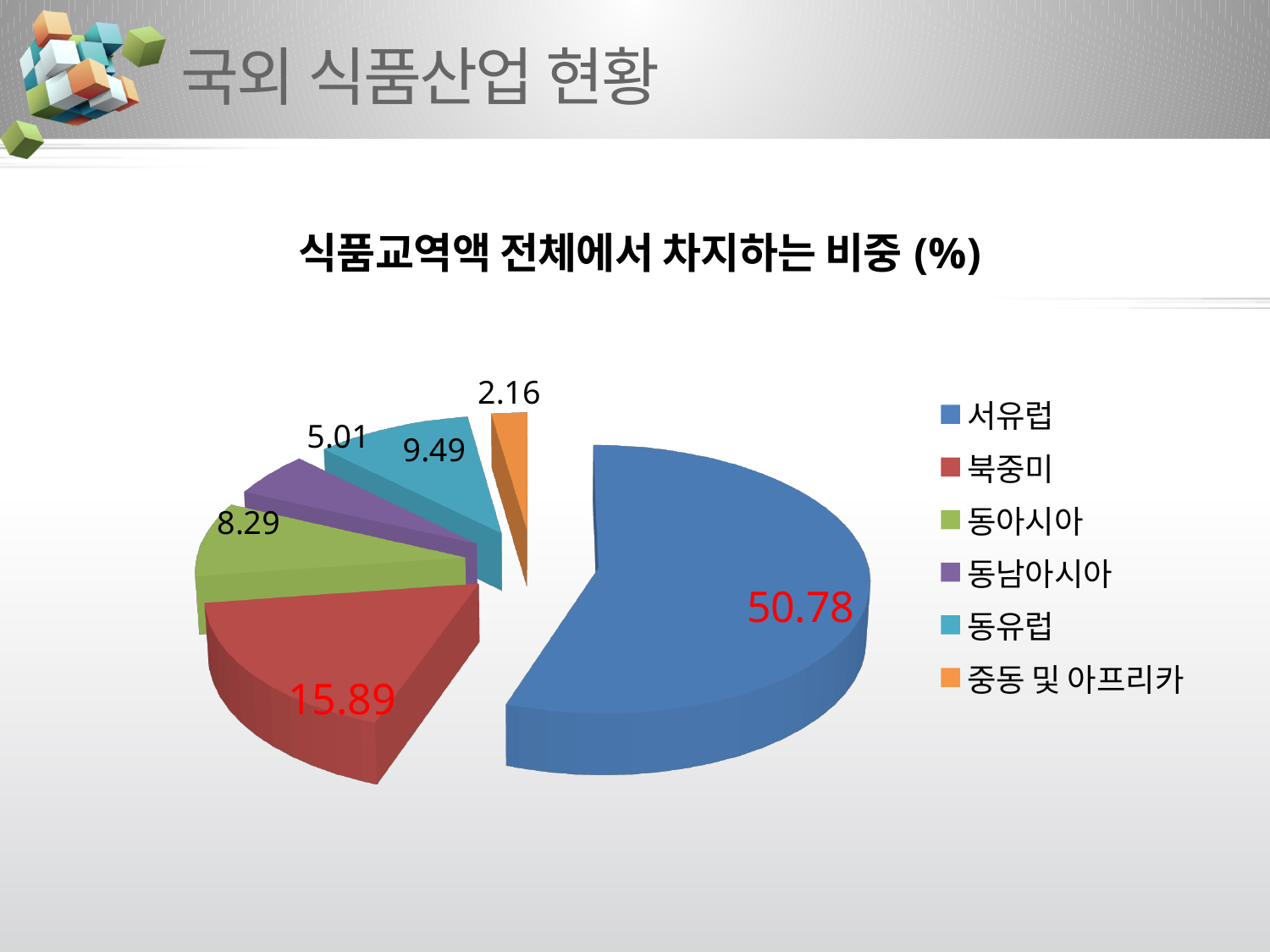
What type of chart is shown on the slide? pie chart What is the title of the chart? 식품교역액 전체에서 차지하는 비중 (%) What colour is the slice for 동남아시아? purple How many categories does the pie chart have? 6 What is the value for 서유럽? 50.78 Which category has the smallest share of the pie? 중동 및 아프리카 What is the value for 중동 및 아프리카? 2.16 What is the value for 동유럽? 9.49 Which category has the largest share of the pie? 서유럽 Which is larger, the value for 동아시아 or the value for 동유럽? 동유럽 What is the difference between the values for 서유럽 and 북중미? 34.89 What is the value for 북중미? 15.89